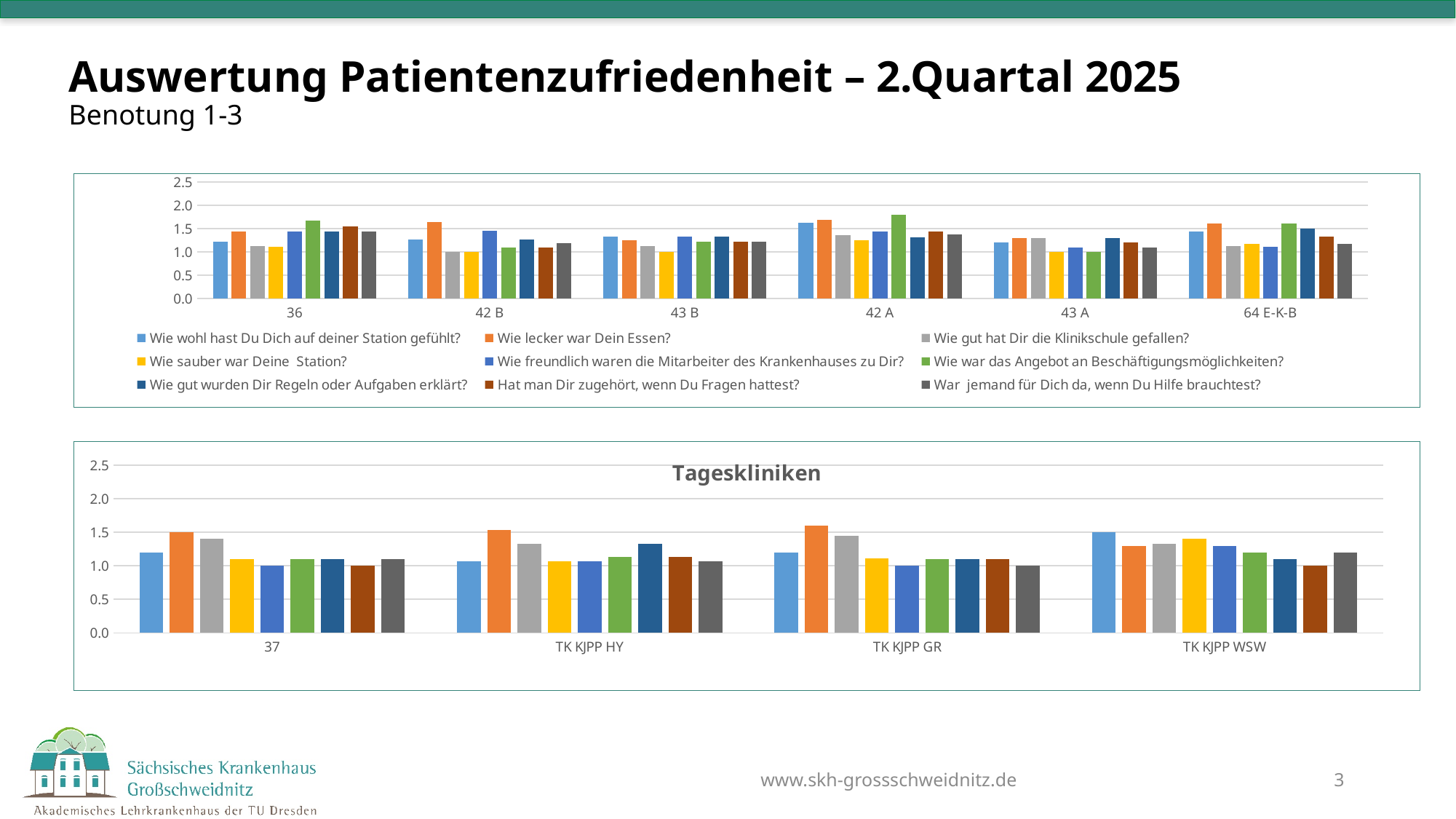
In the top chart, which colour represents the series 'Wie lecker war Dein Essen?'? orange In the top chart, which series has the highest value for category 42 A? Wie war das Angebot an Beschäftigungsmöglichkeiten? In the top chart, is the value of 'Wie sauber war Deine Station?' for 42 B greater or less than 1.5? less In the bottom chart 'Tageskliniken', is the value of 'Wie gut wurden Dir Regeln oder Aufgaben erklärt?' for TK KJPP HY greater or less than 1.5? less How many categories are shown on the x axis of the bottom chart titled 'Tageskliniken'? 4 What is the title of the bottom chart? Tageskliniken What kind of chart is the top chart on the slide? bar chart In the top chart, is the value of 'Wie war das Angebot an Beschäftigungsmöglichkeiten?' for 42 A greater or less than 1.5? greater In the bottom chart 'Tageskliniken', which series has the highest value for TK KJPP GR? Wie lecker war Dein Essen? How many series does the legend of the top chart list? 9 How many categories are shown on the x axis of the top chart? 6